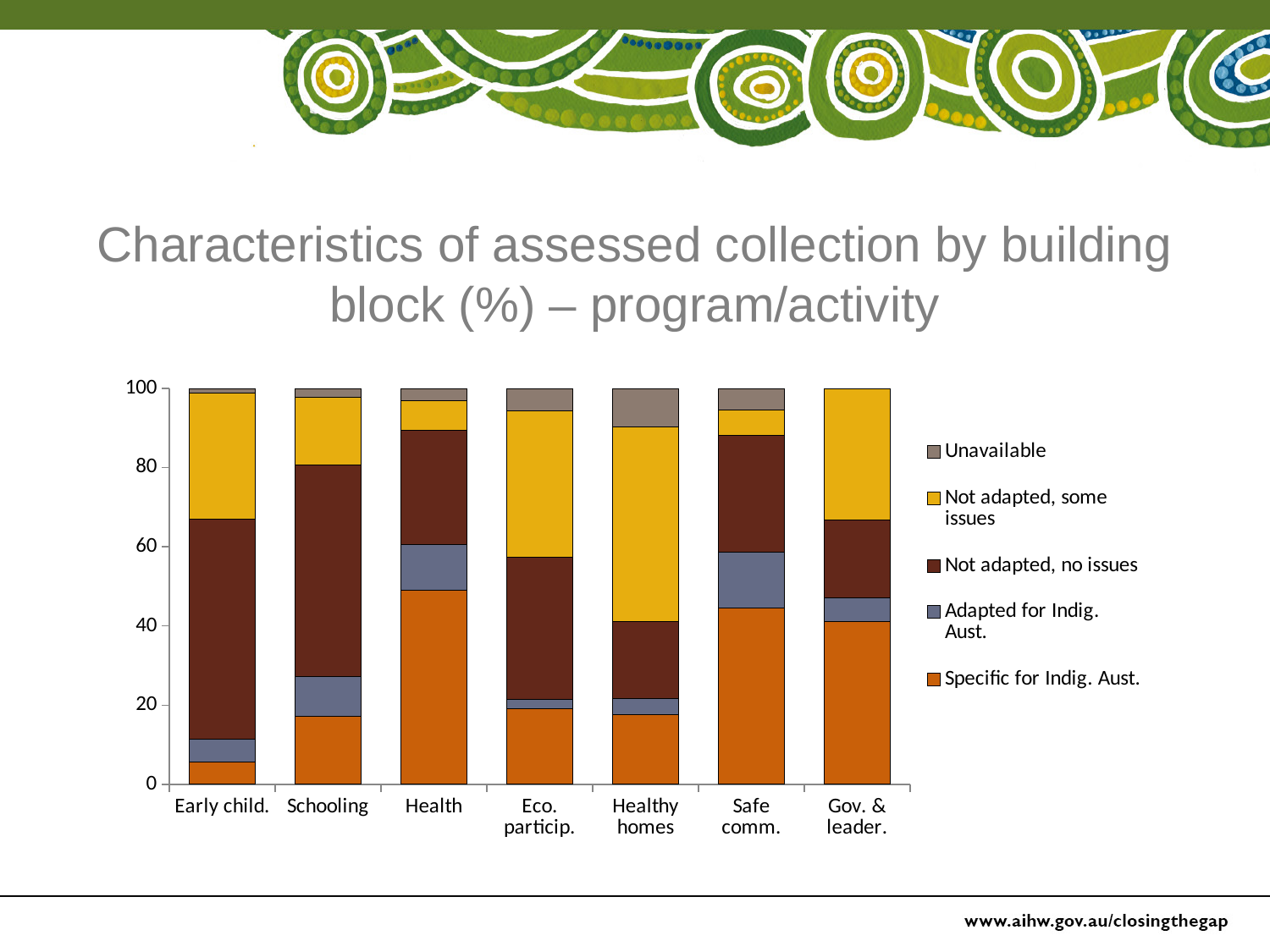
Which series is listed first (at the top) in the legend? Unavailable Is the 'Specific for Indig. Aust.' value for Early child. greater or less than 20? less Is the 'Specific for Indig. Aust.' value for Health greater or less than 40? greater Which building block has the largest 'Not adapted, some issues' segment? Healthy homes How many building block categories are shown along the x axis? 7 Which building block has the largest 'Specific for Indig. Aust.' segment? Health Which has a larger 'Specific for Indig. Aust.' segment, Health or Schooling? Health What is the title of the chart on the slide? Characteristics of assessed collection by building block (%) – program/activity What kind of chart is shown on the slide? Stacked bar chart How many series does the legend list? 5 Which building block has the smallest 'Specific for Indig. Aust.' segment? Early child. Which has a larger 'Unavailable' segment, Healthy homes or Early child.? Healthy homes